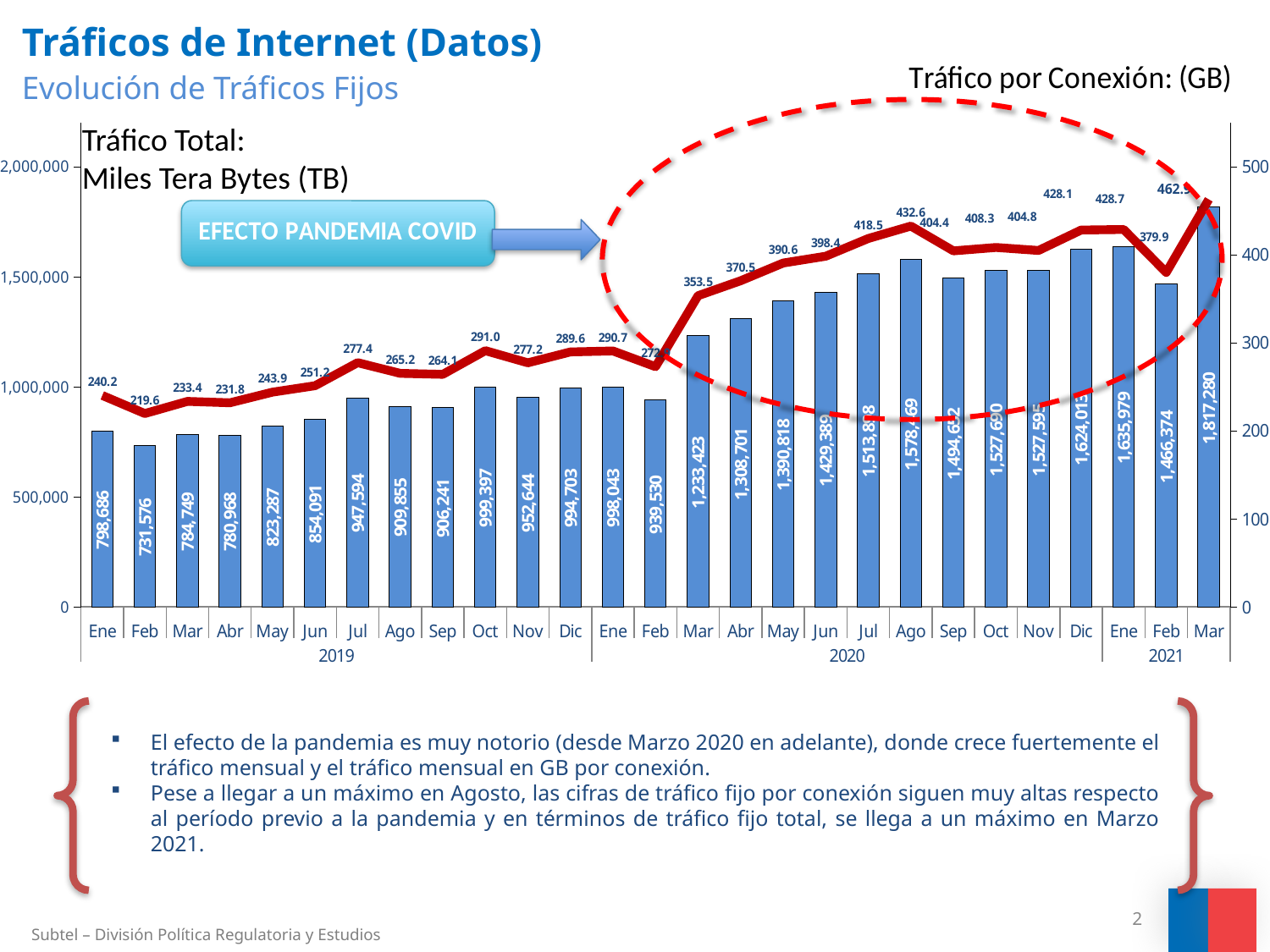
Which month has the lowest traffic per connection (GB) on the line? Feb 2019 What is the traffic per connection (GB) shown for Ago 2020? 432.6 What is the total fixed traffic value shown for Feb 2019? 731,576 Which month has the lowest total fixed traffic bar? Feb 2019 What is the difference in total fixed traffic between Mar 2021 and Feb 2021? 350,906 What is the difference in traffic per connection (GB) between Ago 2020 and Mar 2020? 79.1 What is the traffic per connection (GB) shown for Mar 2020? 353.5 What kind of chart is used to show the total fixed traffic (Miles Tera Bytes)? Bar chart Which month has the highest total fixed traffic bar? Mar 2021 Which is larger, the total fixed traffic bar for Oct 2019 or for Nov 2019? Oct 2019 How many months are plotted on the x axis? 27 What is the total fixed traffic (Miles Tera Bytes) shown for Mar 2021? 1,817,280